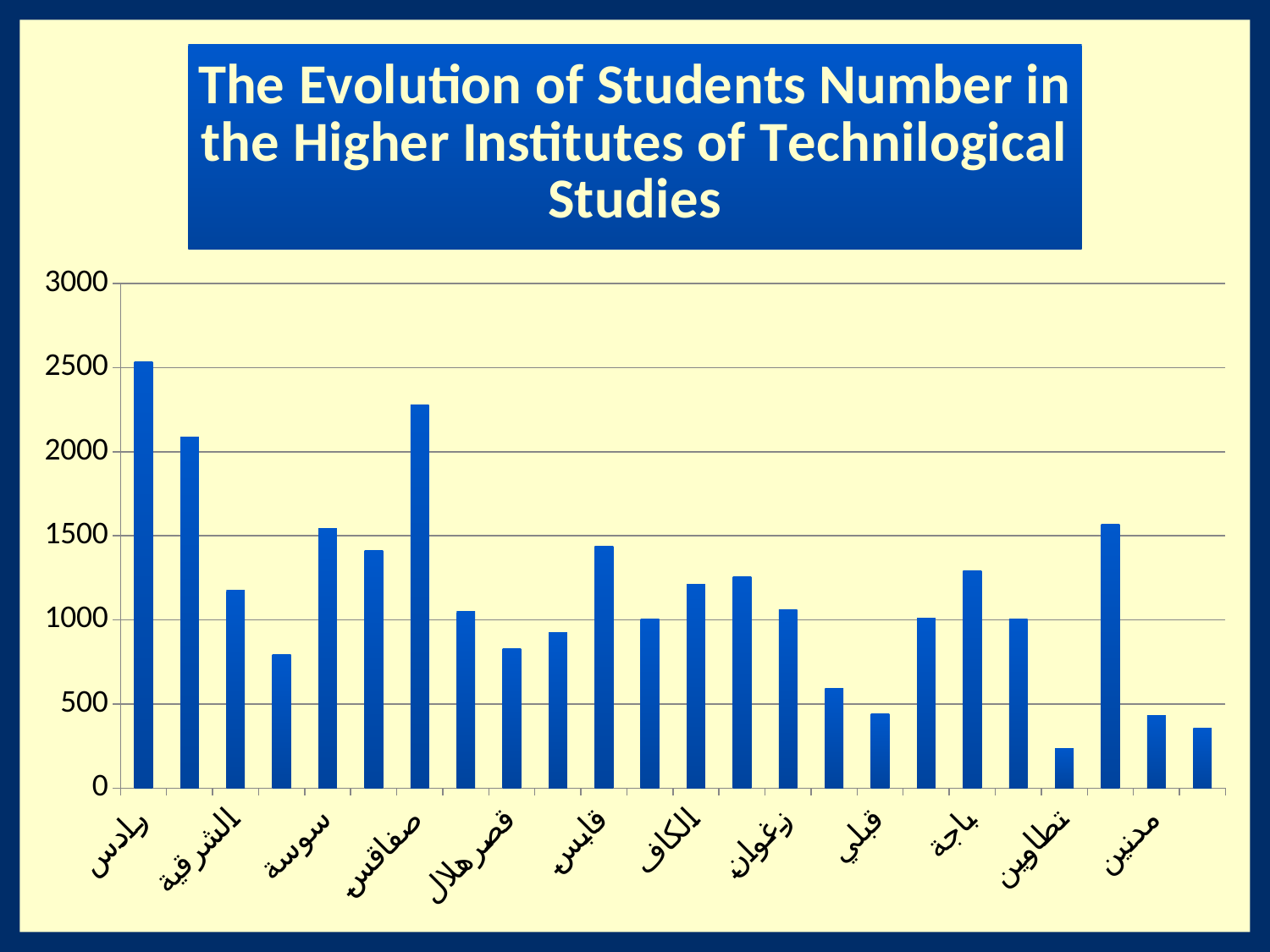
Is the value for صفاقس greater or less than 2000? greater Is the value for رادس greater or less than 2000? greater Which category has the highest value? رادس Which is larger, the value for رادس or the value for صفاقس? رادس Is the value for قابس greater or less than 1500? less What is the title of the chart? The Evolution of Students Number in the Higher Institutes of Technilogical Studies What kind of chart is shown on the slide? bar chart